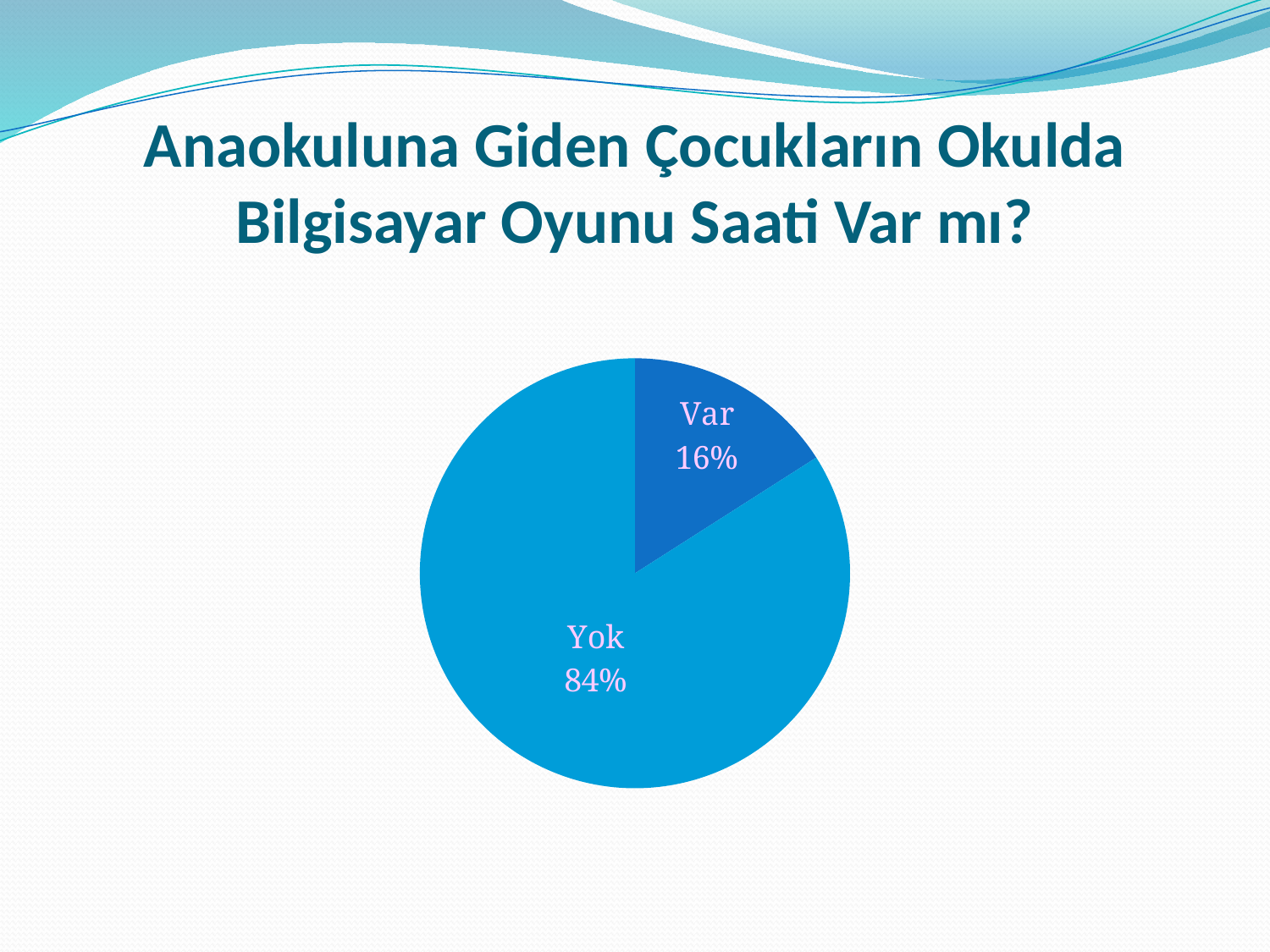
What is the value shown for the "Var" category? 16% What is the difference in percentage points between the "Yok" and "Var" slices? 68 What is the value shown for the "Yok" category? 84% What share of the pie does the "Var" slice represent? 16% Which is larger, the "Var" slice or the "Yok" slice? Yok What type of chart is shown on the slide? pie chart Which slice is the largest in the pie chart? Yok What share of the pie does the "Yok" slice represent? 84% How many slices does the pie chart have? 2 Which slice is the smallest in the pie chart? Var What is the title of the slide containing the pie chart? Anaokuluna Giden Çocukların Okulda Bilgisayar Oyunu Saati Var mı?